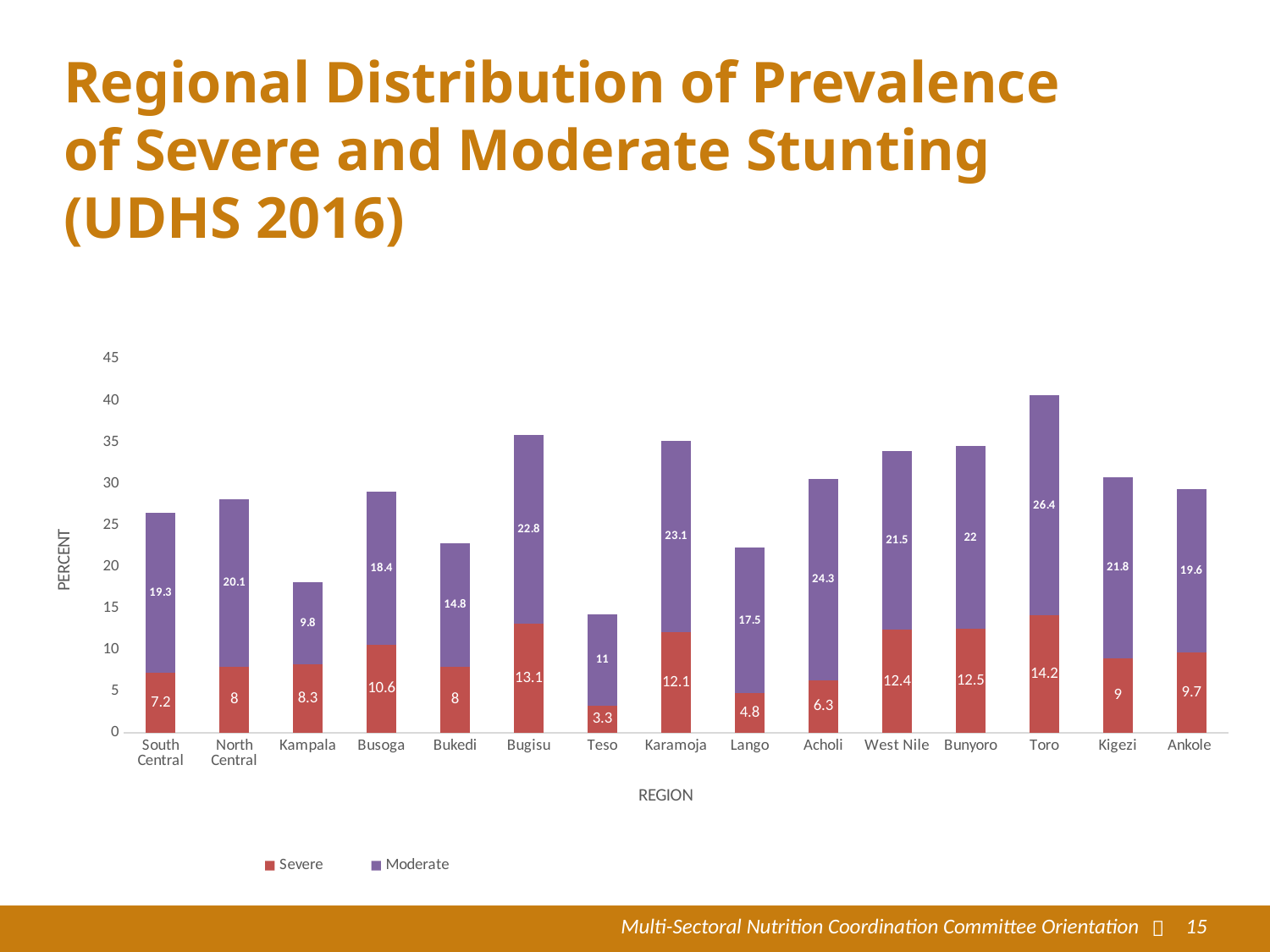
Which is larger, the Severe value for Bugisu or the Severe value for Karamoja? Bugisu How many series does the legend list? 2 What is the total stacked value (Severe plus Moderate) for Teso? 14.3 What is the Severe stunting value for Busoga? 10.6 What is the Severe stunting value for Teso? 3.3 What kind of chart is shown on the slide? Stacked bar chart Which region has the highest Severe stunting value? Toro Which region has the lowest Moderate stunting value? Kampala What is the Moderate stunting value for Acholi? 24.3 How many regions are shown on the x axis? 15 What is the difference between the Moderate values for Toro and Kigezi? 4.6 What is the total stacked value (Severe plus Moderate) for Toro? 40.6